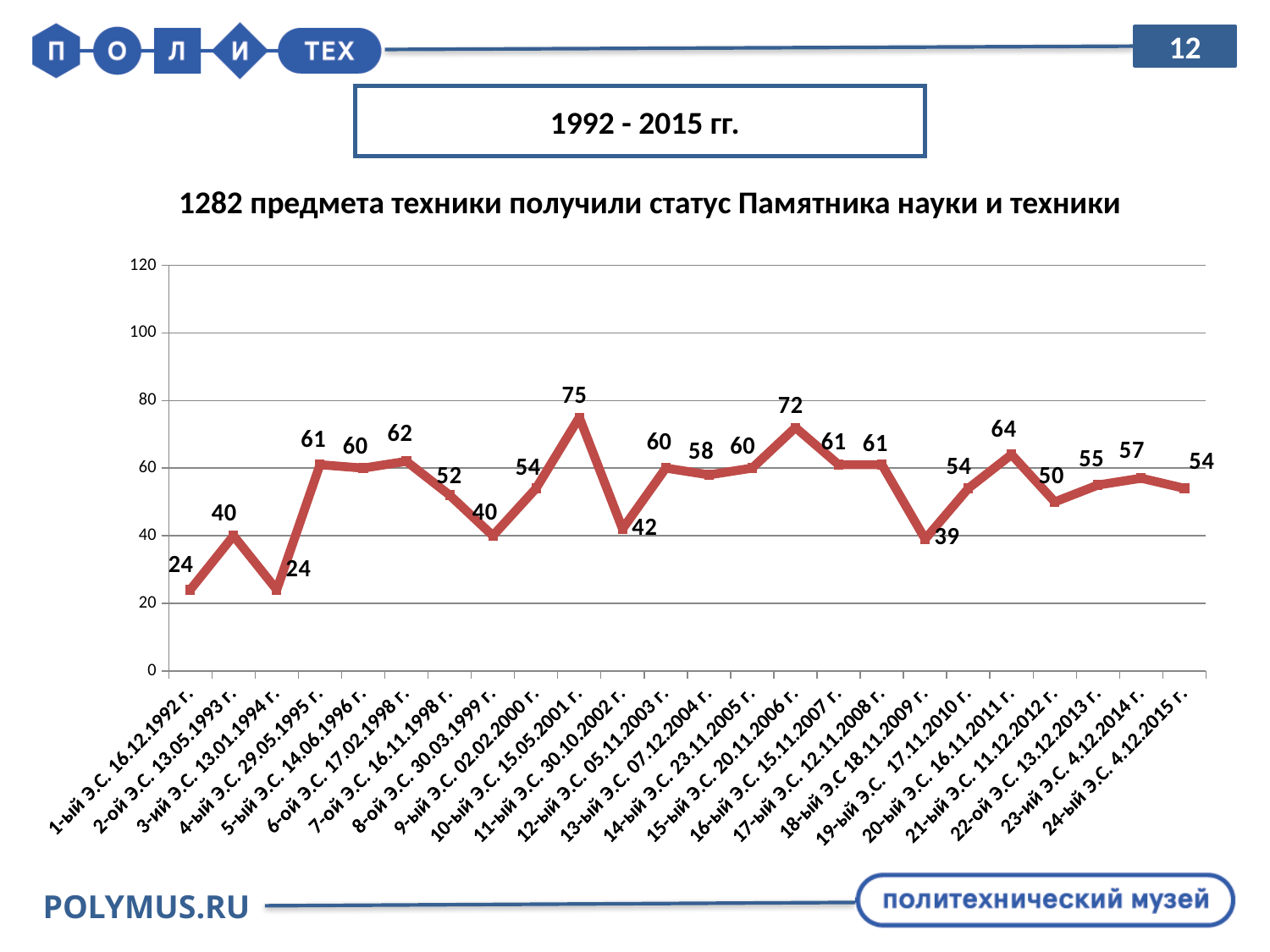
Which is larger, the value for "20-ый Э.С. 16.11.2011 г." or the value for "21-ый Э.С. 11.12.2012 г."? 20-ый Э.С. 16.11.2011 г. Is the value for "18-ый Э.С. 18.11.2009 г." greater or less than 40? less What is the value for "24-ый Э.С. 4.12.2015 г."? 54 What is the title of the chart? 1282 предмета техники получили статус Памятника науки и техники What is the lowest value shown on the chart? 39 What is the value for "1-ый Э.С. 16.12.1992 г."? 24 What type of chart is shown on the slide? line chart Which category has the highest value? 10-ый Э.С. 15.05.2001 г. How many data points are plotted on the chart? 24